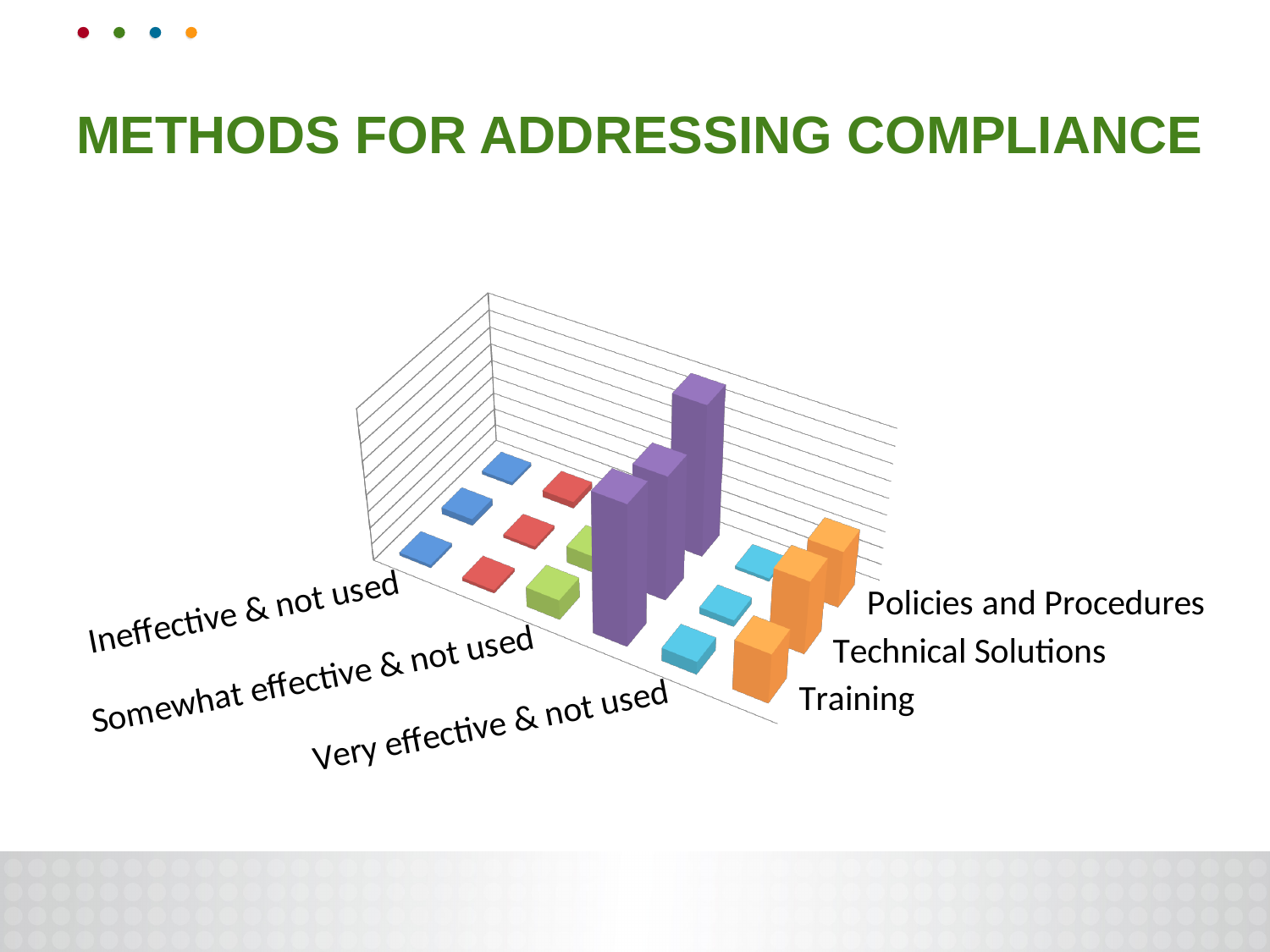
What is the title of the chart on the slide? METHODS FOR ADDRESSING COMPLIANCE What kind of chart is shown on the slide? bar chart Among the purple bars, which method has the shortest bar? Technical Solutions Are the bars for 'Ineffective & not used' taller or shorter than the purple bars? shorter Is the purple bar for Policies and Procedures taller or shorter than the purple bar for Training? taller Among the purple bars, which method has the tallest bar? Policies and Procedures What colour are the tallest bars on the chart? purple How many methods are listed along the depth axis of the chart (Training, Technical Solutions, Policies and Procedures)? 3